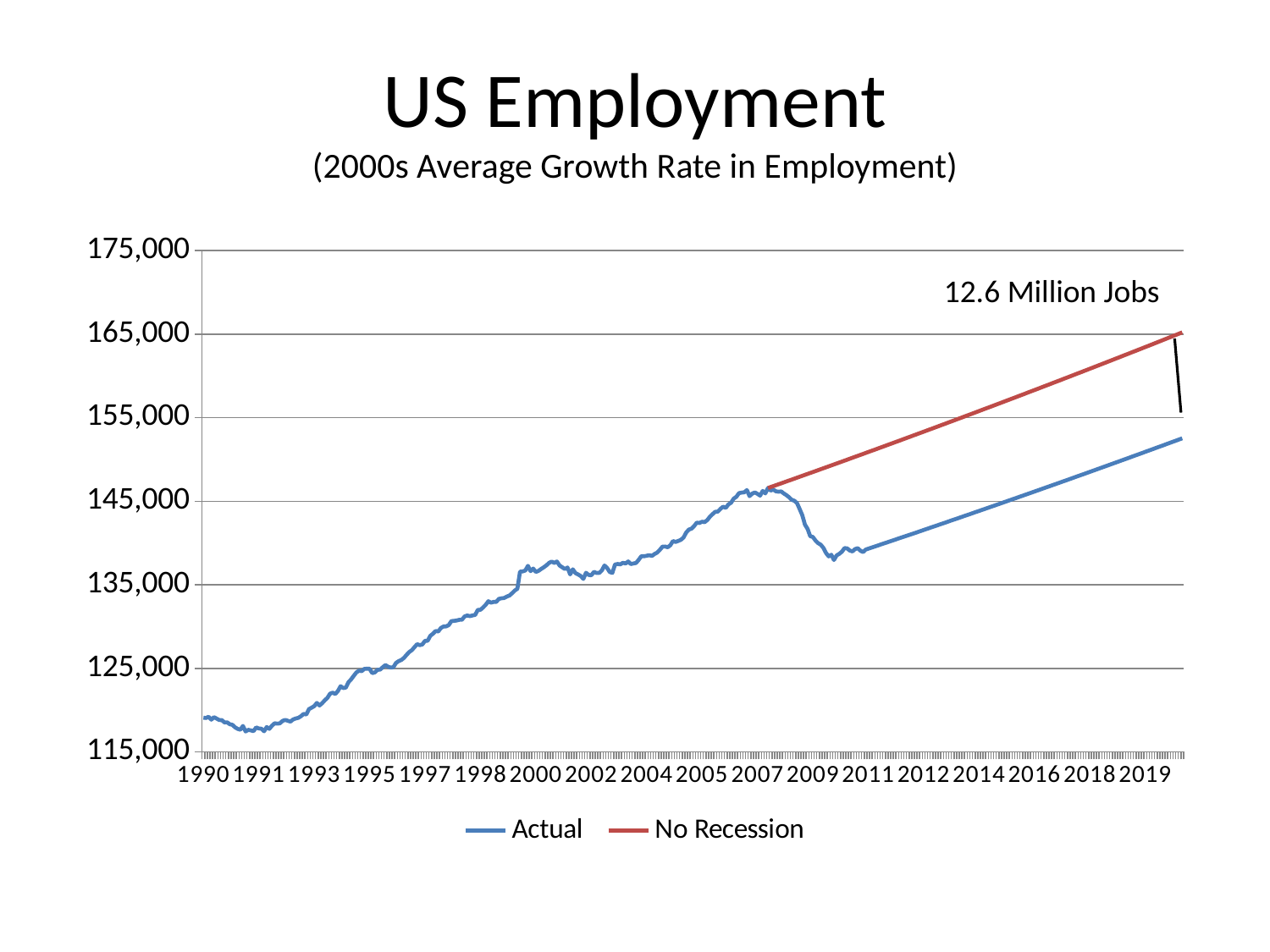
What kind of chart is shown on the slide? line chart At the end of the series (2019), which is higher: the Actual line or the No Recession line? No Recession Is the Actual value at the end of the series (2019) greater or less than 145,000? greater Does the Actual line rise or fall overall between 1990 and 2007? rise Is the Actual value at the end of the series (2019) greater or less than 155,000? less Is the Actual value around 2010 greater or less than 145,000? less How many series does the legend list? 2 What are the two series named in the legend? Actual and No Recession Does the Actual line rise or fall between 2007 and 2009? fall What is the title of the chart? US Employment